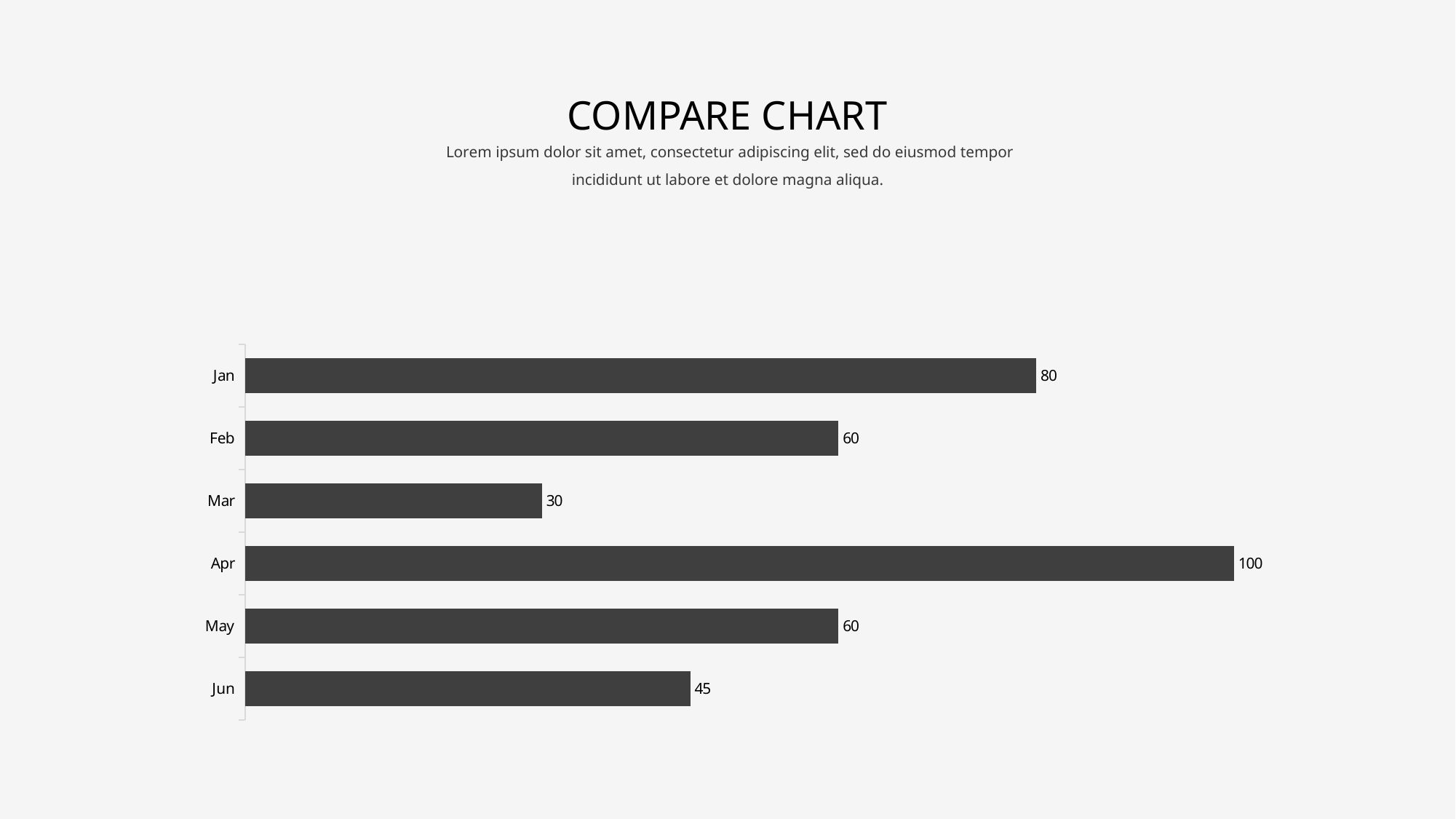
Which is larger, the value for Jan or the value for Jun? Jan What kind of chart is shown on the slide? Bar chart What is the difference between the values for Apr and Jan? 20 Which two months have the same value of 60? Feb and May What is the value for Mar? 30 What is the title of the slide? COMPARE CHART What is the difference between the values for Feb and Mar? 30 Which month has the highest value? Apr How many months are shown on the chart? 6 Which month has the lowest value? Mar What is the value for Jun? 45 What is the value for Jan? 80